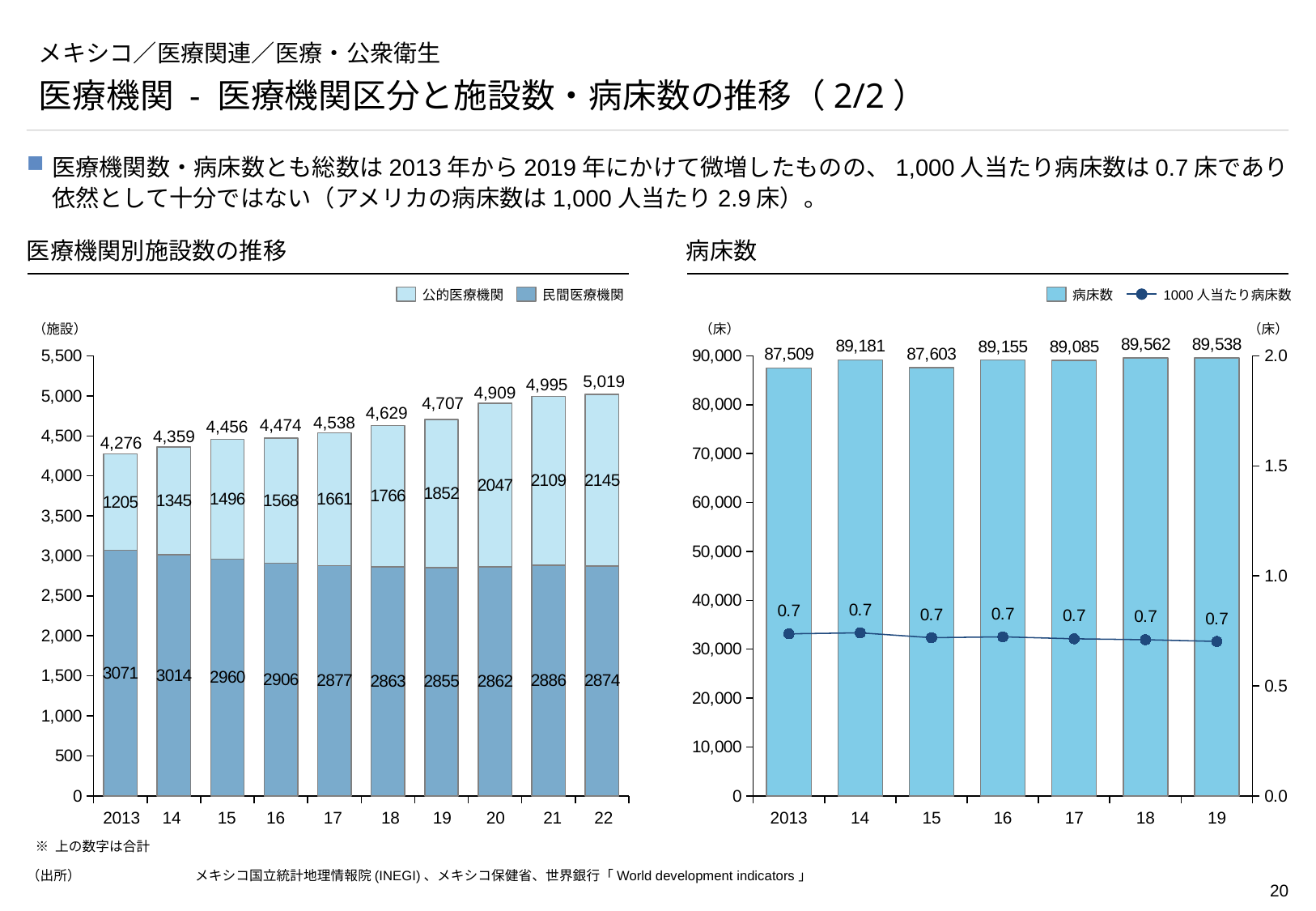
In the 医療機関別施設数の推移 chart, how many years are shown on the x axis? 10 In the 医療機関別施設数の推移 chart, how many series does the legend list? 2 In the 病床数 chart, what is the value of 1000人当たり病床数 in 2019? 0.7 In the 病床数 chart, which year has the highest number of beds? 2018 In the 医療機関別施設数の推移 chart, what is the value for 民間医療機関 in 2013? 3071 In the 病床数 chart, what is the number of beds in 2018? 89,562 In the 病床数 chart, what is the difference in beds between 2014 and 2013? 1,672 In the 医療機関別施設数の推移 chart, what is the value for 公的医療機関 in 2020? 2047 In the 医療機関別施設数の推移 chart, what is the total number of facilities in 2022? 5,019 In the 病床数 chart, is the number of beds in 2015 greater or less than 80,000? greater In the 医療機関別施設数の推移 chart, what is the difference between the 公的医療機関 values for 2022 and 2013? 940 In the 医療機関別施設数の推移 chart, which year has the lowest total number of facilities? 2013